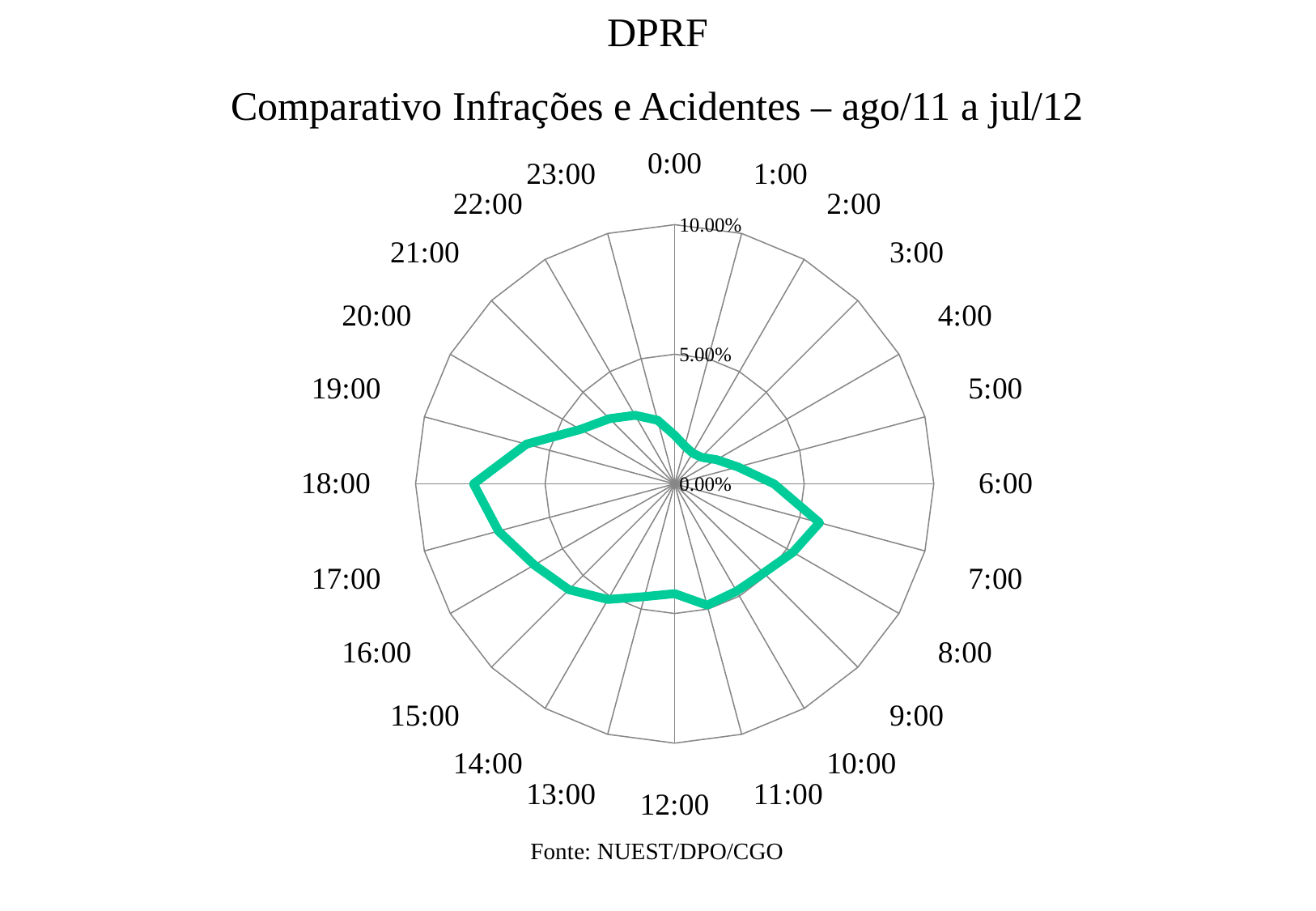
What is the highest percentage tick shown on the chart's radial axis? 10.00% Which is larger, the value for 18:00 or the value for 0:00? 18:00 Is the value for 7:00 greater or less than 5.00%? greater What is the title of the chart? Comparativo Infrações e Acidentes – ago/11 a jul/12 How many hour categories are plotted around the chart? 24 Is the value for 17:00 greater or less than 5.00%? greater Is the value for 2:00 greater or less than 5.00%? less Which is larger, the value for 7:00 or the value for 1:00? 7:00 Which hour has the highest value on the chart? 18:00 What kind of chart is shown on the slide? Radar chart